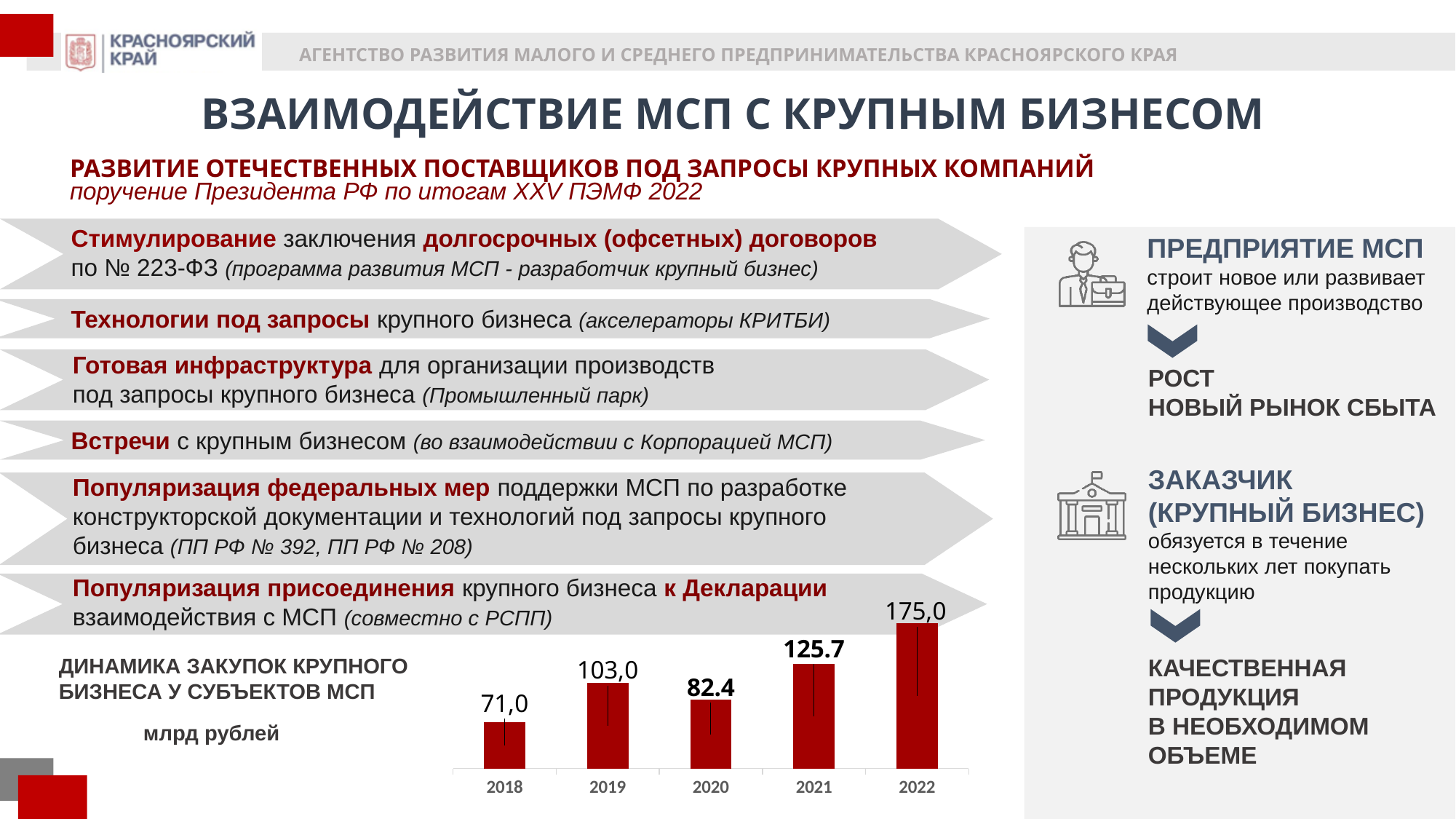
In the chart 'Динамика закупок крупного бизнеса у субъектов МСП', what is the difference between the values for 2022 and 2018? 104,0 Which year has the highest value in the chart 'Динамика закупок крупного бизнеса у субъектов МСП'? 2022 Which year has the lowest value in the chart 'Динамика закупок крупного бизнеса у субъектов МСП'? 2018 What is the value for 2018 in the chart 'Динамика закупок крупного бизнеса у субъектов МСП'? 71,0 What is the value for 2021 in the chart 'Динамика закупок крупного бизнеса у субъектов МСП'? 125.7 What kind of chart is 'Динамика закупок крупного бизнеса у субъектов МСП'? bar chart In the chart 'Динамика закупок крупного бизнеса у субъектов МСП', what is the difference between the values for 2021 and 2020? 43.3 In the chart 'Динамика закупок крупного бизнеса у субъектов МСП', which is larger: the value for 2019 or the value for 2020? 2019 What is the value for 2020 in the chart 'Динамика закупок крупного бизнеса у субъектов МСП'? 82.4 What is the value for 2022 in the chart 'Динамика закупок крупного бизнеса у субъектов МСП'? 175,0 In what units are the values of the chart 'Динамика закупок крупного бизнеса у субъектов МСП' given? млрд рублей How many years are shown in the chart 'Динамика закупок крупного бизнеса у субъектов МСП'? 5